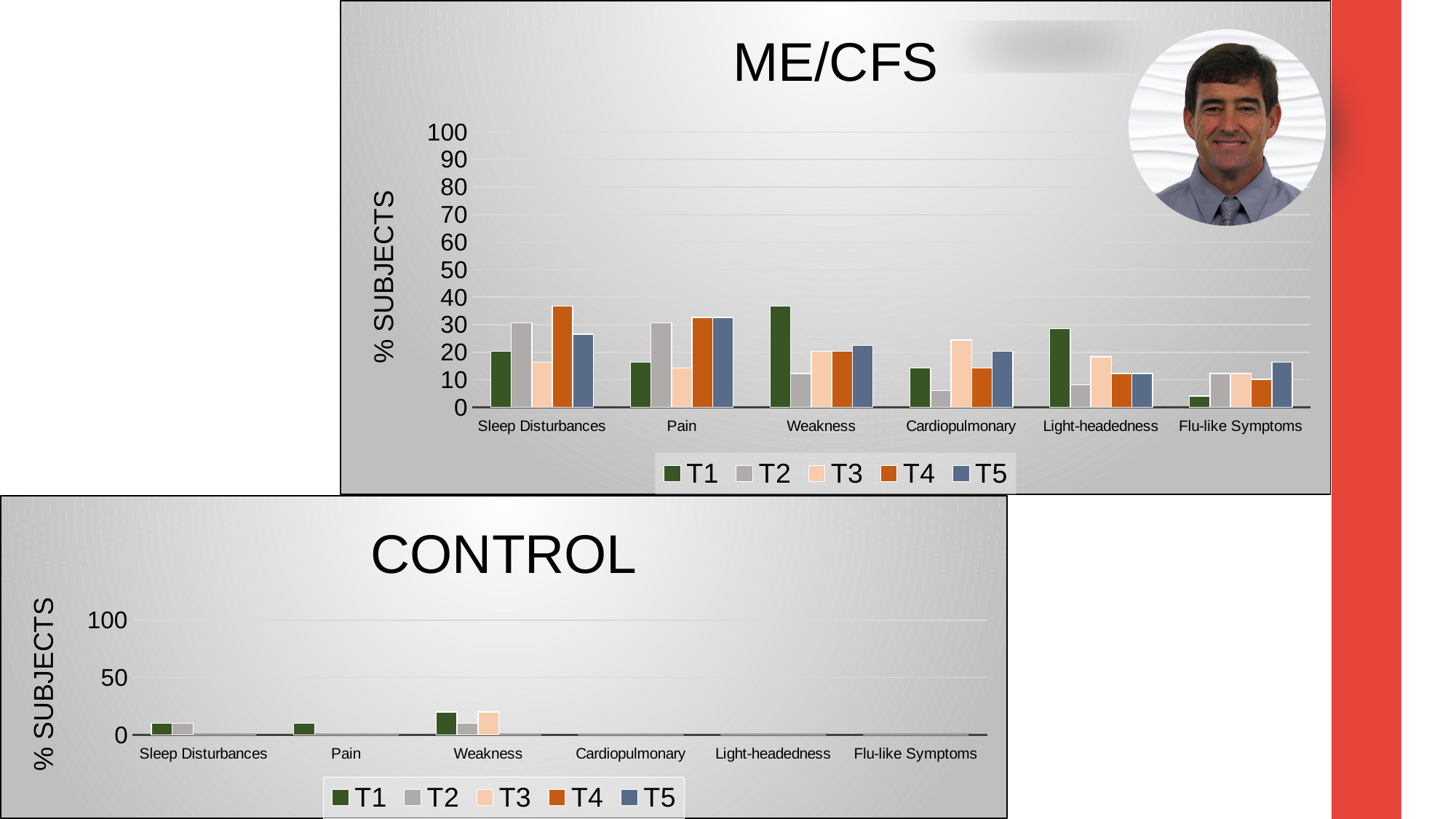
What is the y-axis label of the CONTROL chart? % SUBJECTS In the ME/CFS chart, is the T1 value for Flu-like Symptoms greater or less than 10? less What type of chart is the ME/CFS chart? bar chart How many series does the legend of the ME/CFS chart list? 5 In the ME/CFS chart, which is larger for Weakness: T1 or T2? T1 In the ME/CFS chart, which series has the highest value for Weakness? T1 In the ME/CFS chart, which series has the lowest value for Flu-like Symptoms? T1 In the CONTROL chart, is the T1 value for Weakness greater or less than 50? less In the ME/CFS chart, which series has the highest value for Sleep Disturbances? T4 In the ME/CFS chart, is the T4 value for Sleep Disturbances greater or less than 30? greater How many symptom categories are shown on the x axis of the ME/CFS chart? 6 In the ME/CFS chart, which series has the lowest value for Cardiopulmonary? T2